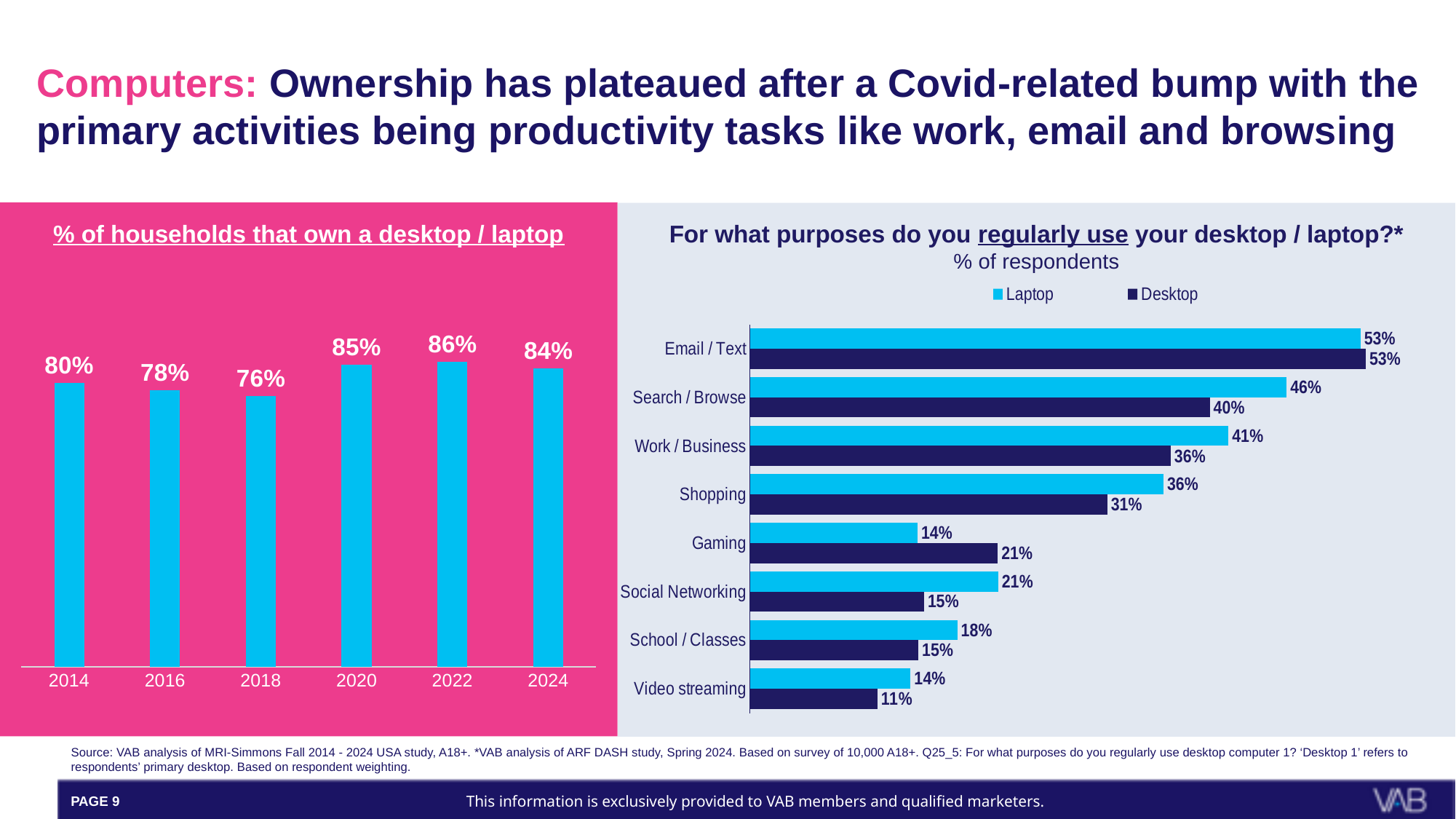
In the 'For what purposes do you regularly use your desktop / laptop?' chart, how many series does the legend list? 2 In the 'For what purposes do you regularly use your desktop / laptop?' chart, what is the difference between the Laptop and Desktop values for Shopping? 5 percentage points In the '% of households that own a desktop / laptop' chart, what is the value for 2020? 85% In the 'For what purposes do you regularly use your desktop / laptop?' chart, what is the Laptop value for Search / Browse? 46% In the '% of households that own a desktop / laptop' chart, which year has the highest value? 2022 In the 'For what purposes do you regularly use your desktop / laptop?' chart, what is the Desktop value for Gaming? 21% In the 'For what purposes do you regularly use your desktop / laptop?' chart, which is larger for Gaming: the Laptop value or the Desktop value? Desktop In the 'For what purposes do you regularly use your desktop / laptop?' chart, which purpose has the lowest Desktop value? Video streaming In the '% of households that own a desktop / laptop' chart, what kind of chart is it? Bar chart In the '% of households that own a desktop / laptop' chart, how many years are shown? 6 In the '% of households that own a desktop / laptop' chart, which year has the lowest value? 2018 In the '% of households that own a desktop / laptop' chart, what is the difference between the 2022 and 2014 values? 6 percentage points